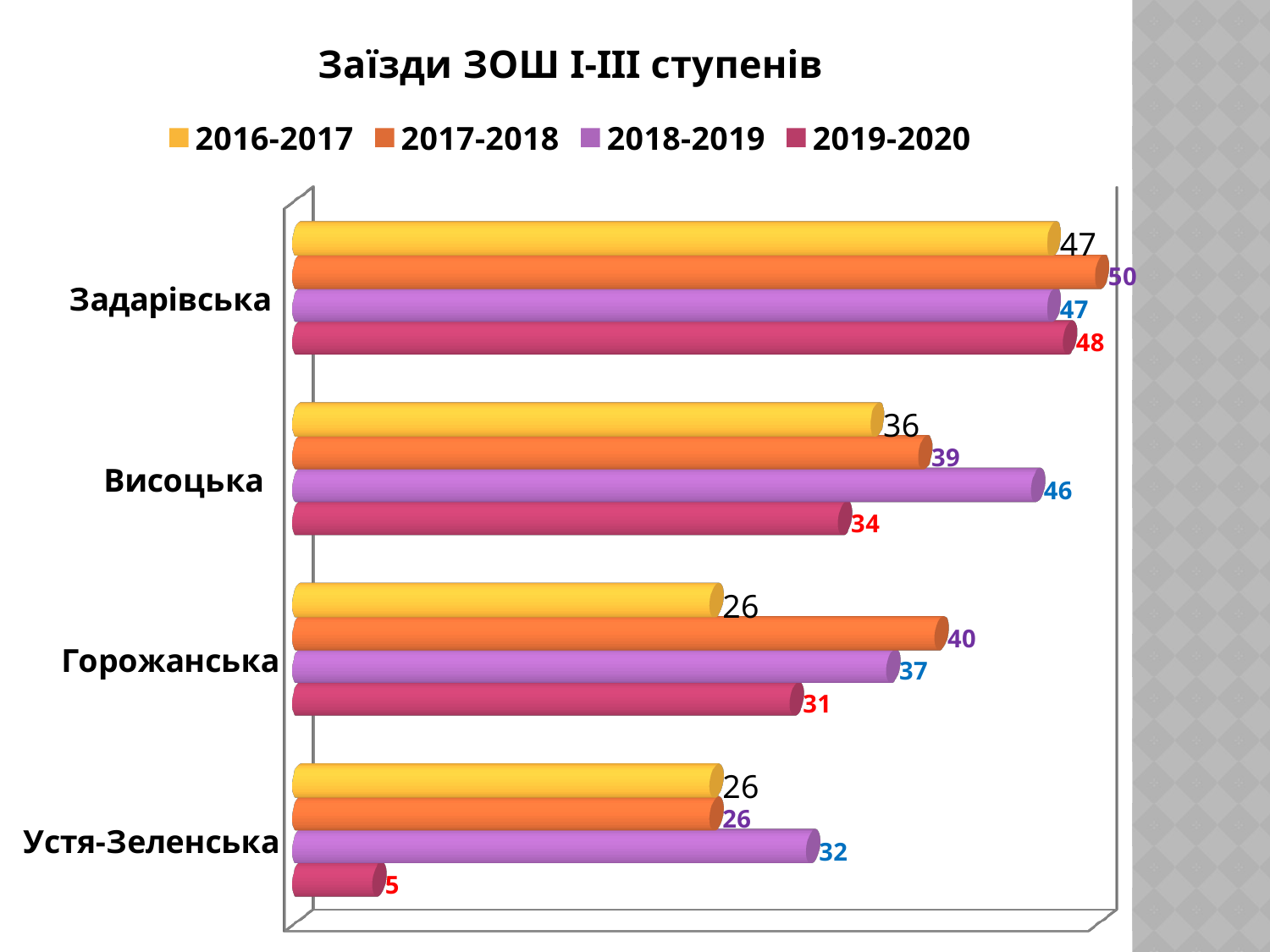
Which is larger for Висоцька: the 2017-2018 value or the 2019-2020 value? 2017-2018 What is the value for Висоцька in the 2018-2019 series? 46 How many categories are shown on the chart? 4 Which category has the lowest value in the 2018-2019 series? Устя-Зеленська How many series does the legend list? 4 What is the difference between the 2017-2018 and 2016-2017 values for Горожанська? 14 What is the value for Горожанська in the 2016-2017 series? 26 What kind of chart is shown on the slide? Bar chart What is the value for Устя-Зеленська in the 2019-2020 series? 5 Which category has the highest value in the 2019-2020 series? Задарівська What is the value for Задарівська in the 2017-2018 series? 50 What is the title of the chart? Заїзди ЗОШ І-ІІІ ступенів